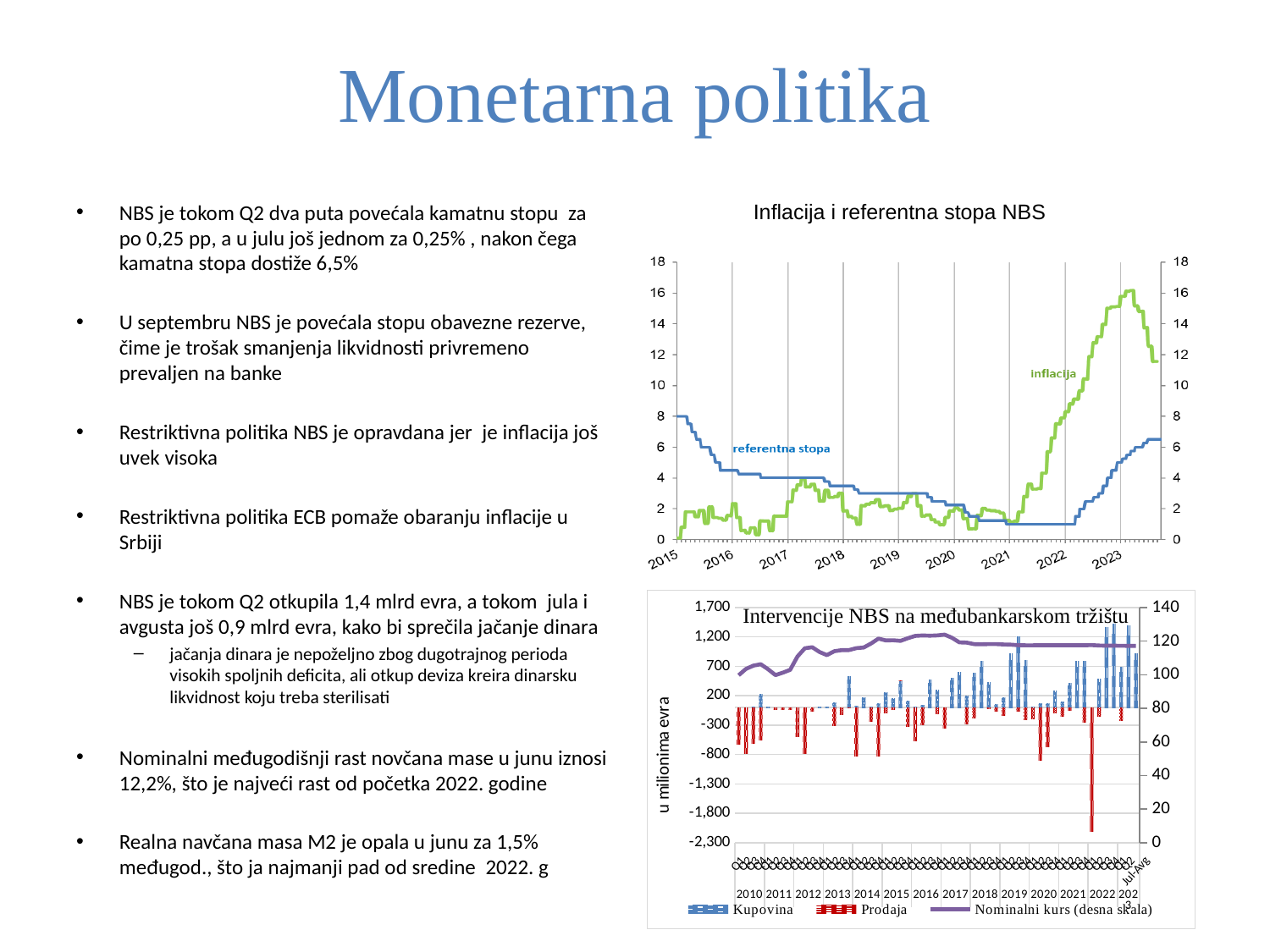
In the bottom chart "Intervencije NBS na međubankarskom tržištu", does the Nominalni kurs line rise or fall between 2010 and 2016? rise What type of chart is the top chart titled "Inflacija i referentna stopa NBS"? line chart In the bottom chart "Intervencije NBS na međubankarskom tržištu", is the Nominalni kurs value in 2010 greater or less than 120? less In the top chart "Inflacija i referentna stopa NBS", does inflacija rise or fall between 2021 and early 2023? rise In the top chart "Inflacija i referentna stopa NBS", which series is higher at the start of 2015: inflacija or referentna stopa? referentna stopa In the top chart "Inflacija i referentna stopa NBS", which series is drawn in green? inflacija How many entries does the legend of the bottom chart "Intervencije NBS na međubankarskom tržištu" list? 3 In the top chart "Inflacija i referentna stopa NBS", is the peak value of inflacija in 2023 greater or less than 14? greater In the top chart "Inflacija i referentna stopa NBS", is the referentna stopa during 2021 greater or less than 2? less In the top chart "Inflacija i referentna stopa NBS", does the referentna stopa rise or fall between 2015 and 2021? fall What is the left vertical axis label of the bottom chart "Intervencije NBS na međubankarskom tržištu"? u milionima evra How many series are plotted in the top chart "Inflacija i referentna stopa NBS"? 2